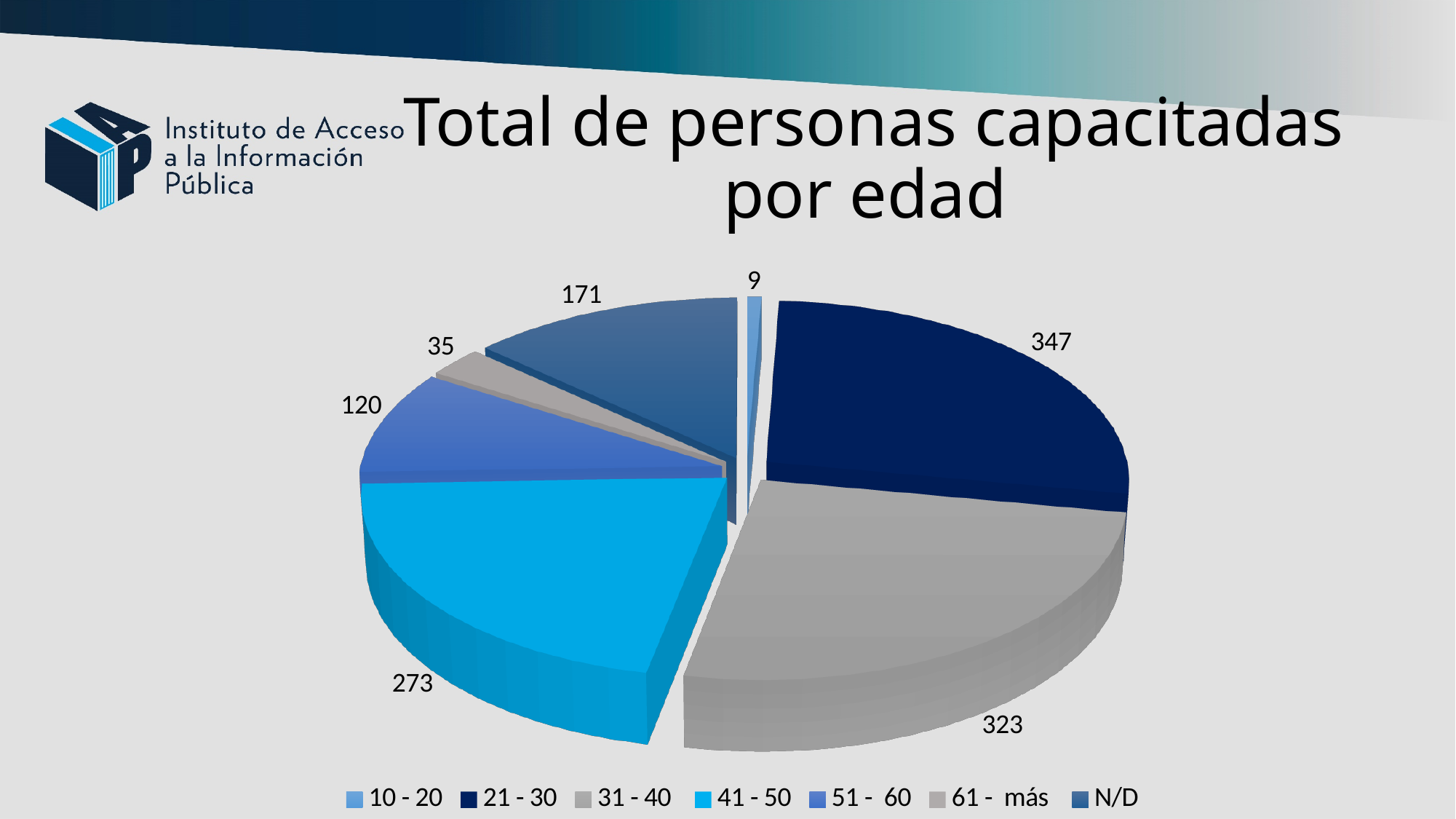
Which age group has the smallest slice? 10 - 20 What is the value for the 21 - 30 slice? 347 What is the title of the chart? Total de personas capacitadas por edad How many slices does the pie chart have? 7 What is the value for the 61 - más slice? 35 What kind of chart is shown on the slide? Pie chart What is the value for the 41 - 50 slice? 273 What is the value for the N/D slice? 171 What is the difference between the 21 - 30 and 31 - 40 values? 24 What is the difference between the N/D and 51 - 60 values? 51 Which age group has the largest slice? 21 - 30 Which is larger, the 41 - 50 slice or the 51 - 60 slice? 41 - 50